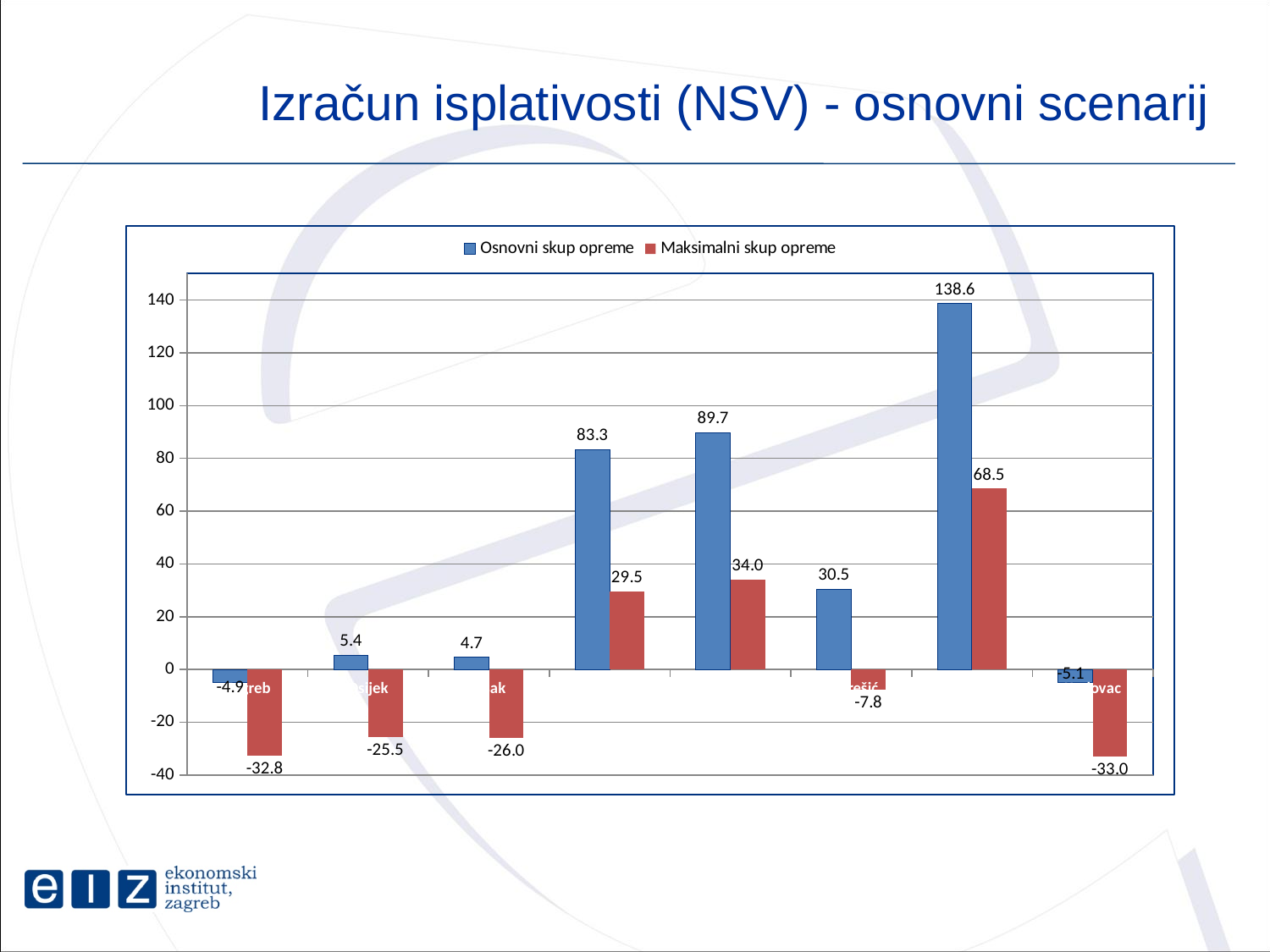
What type of chart is shown on the slide? bar chart What is the highest value in the 'Osnovni skup opreme' series? 138.6 What is the 'Maksimalni skup opreme' value for the fifth category group from the left? 34.0 In the sixth category group from the left, which series has the larger value, 'Osnovni skup opreme' or 'Maksimalni skup opreme'? Osnovni skup opreme What is the lowest value in the 'Maksimalni skup opreme' series? -33.0 What are the two series named in the legend? Osnovni skup opreme and Maksimalni skup opreme How many series does the legend list? 2 What is the highest value in the 'Maksimalni skup opreme' series? 68.5 In the seventh category group from the left, what is the difference between the 'Osnovni skup opreme' value and the 'Maksimalni skup opreme' value? 70.1 What is the 'Osnovni skup opreme' value for the fourth category group from the left? 83.3 How many category groups are plotted on the chart? 8 Which colour represents the series 'Maksimalni skup opreme'? red